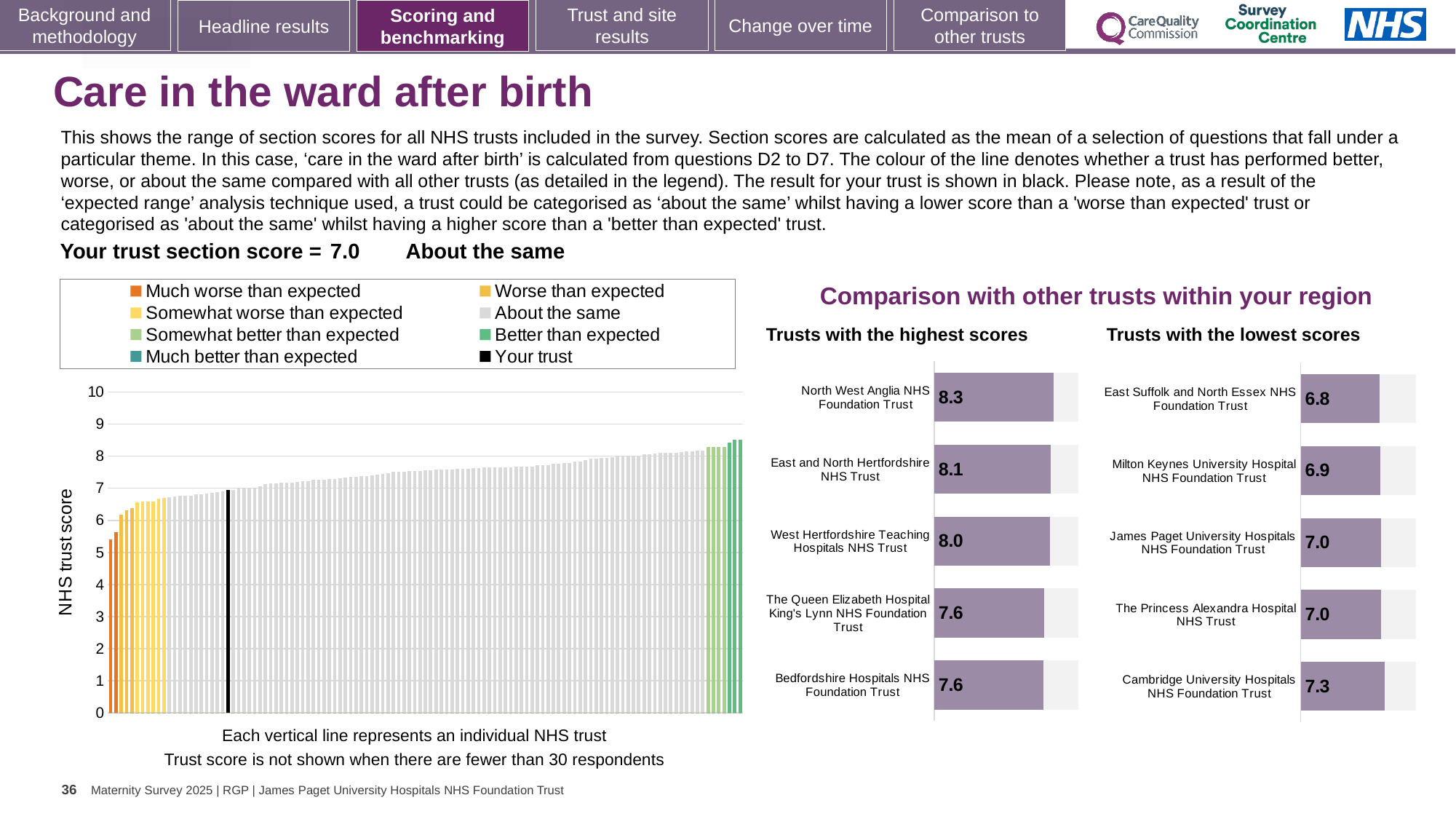
In the 'Trusts with the highest scores' chart, what is the difference between the scores of North West Anglia NHS Foundation Trust and Bedfordshire Hospitals NHS Foundation Trust? 0.7 In the 'Trusts with the highest scores' chart, what is the score for North West Anglia NHS Foundation Trust? 8.3 In the 'Trusts with the lowest scores' chart, which has the higher score: Milton Keynes University Hospital NHS Foundation Trust or Cambridge University Hospitals NHS Foundation Trust? Cambridge University Hospitals NHS Foundation Trust In the large 'NHS trust score' chart on the left, do the values rise or fall from left to right along the x axis? Rise In the 'Trusts with the lowest scores' chart, what is the score for Cambridge University Hospitals NHS Foundation Trust? 7.3 In the 'Trusts with the highest scores' chart, which trust has the highest score? North West Anglia NHS Foundation Trust How many trusts are shown in the 'Trusts with the highest scores' chart? 5 In the 'Trusts with the lowest scores' chart, which trust has the lowest score? East Suffolk and North Essex NHS Foundation Trust What kind of chart is the large 'NHS trust score' chart on the left of the slide? Bar chart What is the section score for your trust shown on the slide? 7.0 In the large 'NHS trust score' chart on the left, is the value of the lowest (leftmost) bar greater or less than 6? less How many entries does the legend above the large 'NHS trust score' chart list? 8